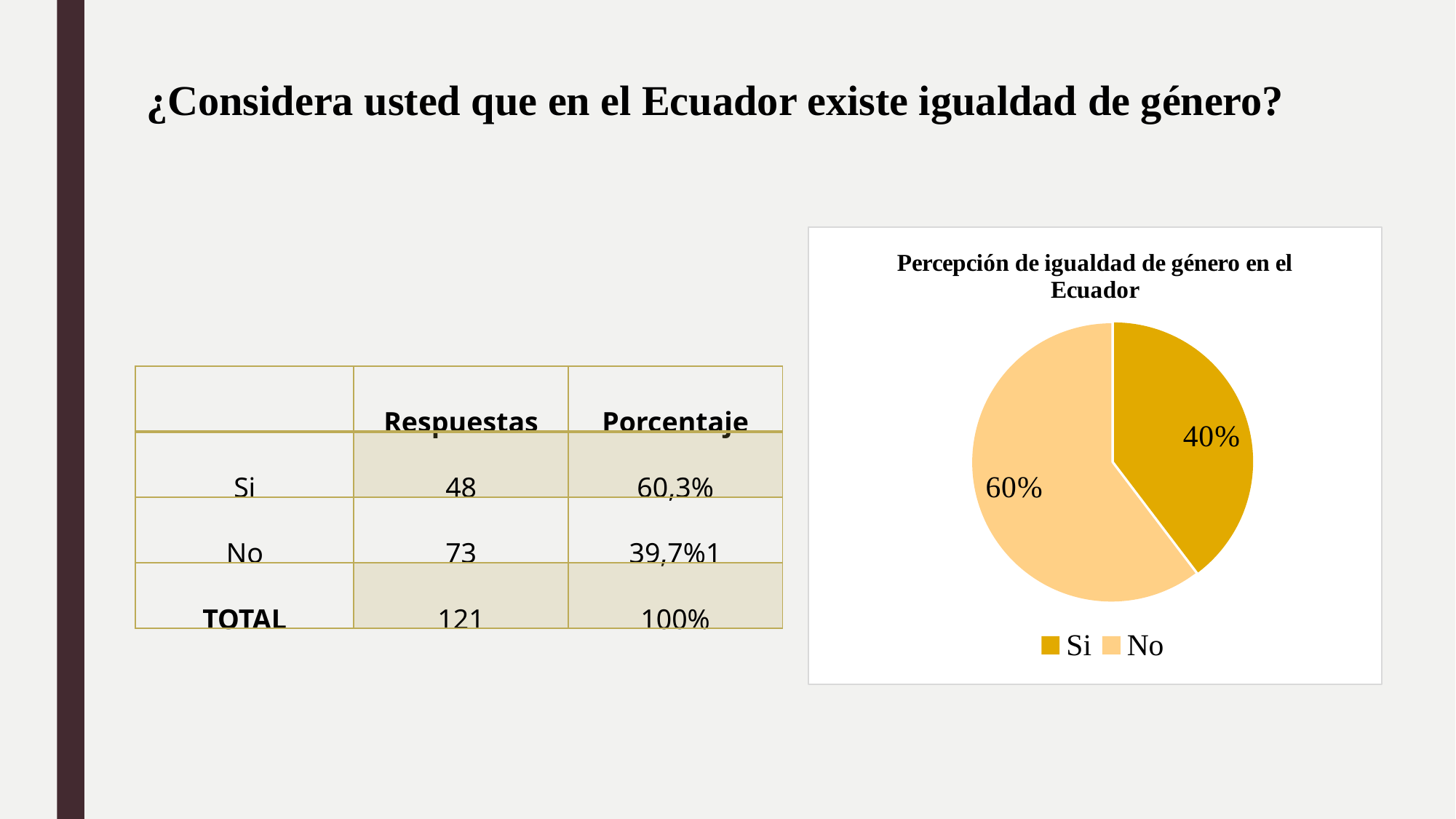
In the pie chart, which is larger, the Si slice or the No slice? No What is the difference in percentage points between the No slice and the Si slice in the pie chart? 20% Which slice of the pie chart is the largest? No What percentage does the pie chart show for Si? 40% What kind of chart is shown on the slide? pie chart Which slice of the pie chart is the smallest? Si What share of the pie does the No slice represent? 60% What is the title of the pie chart? Percepción de igualdad de género en el Ecuador How many entries does the pie chart legend list? 2 What percentage does the pie chart show for No? 60% How many slices does the pie chart have? 2 Which legend entry in the pie chart is shown in the darker orange colour? Si